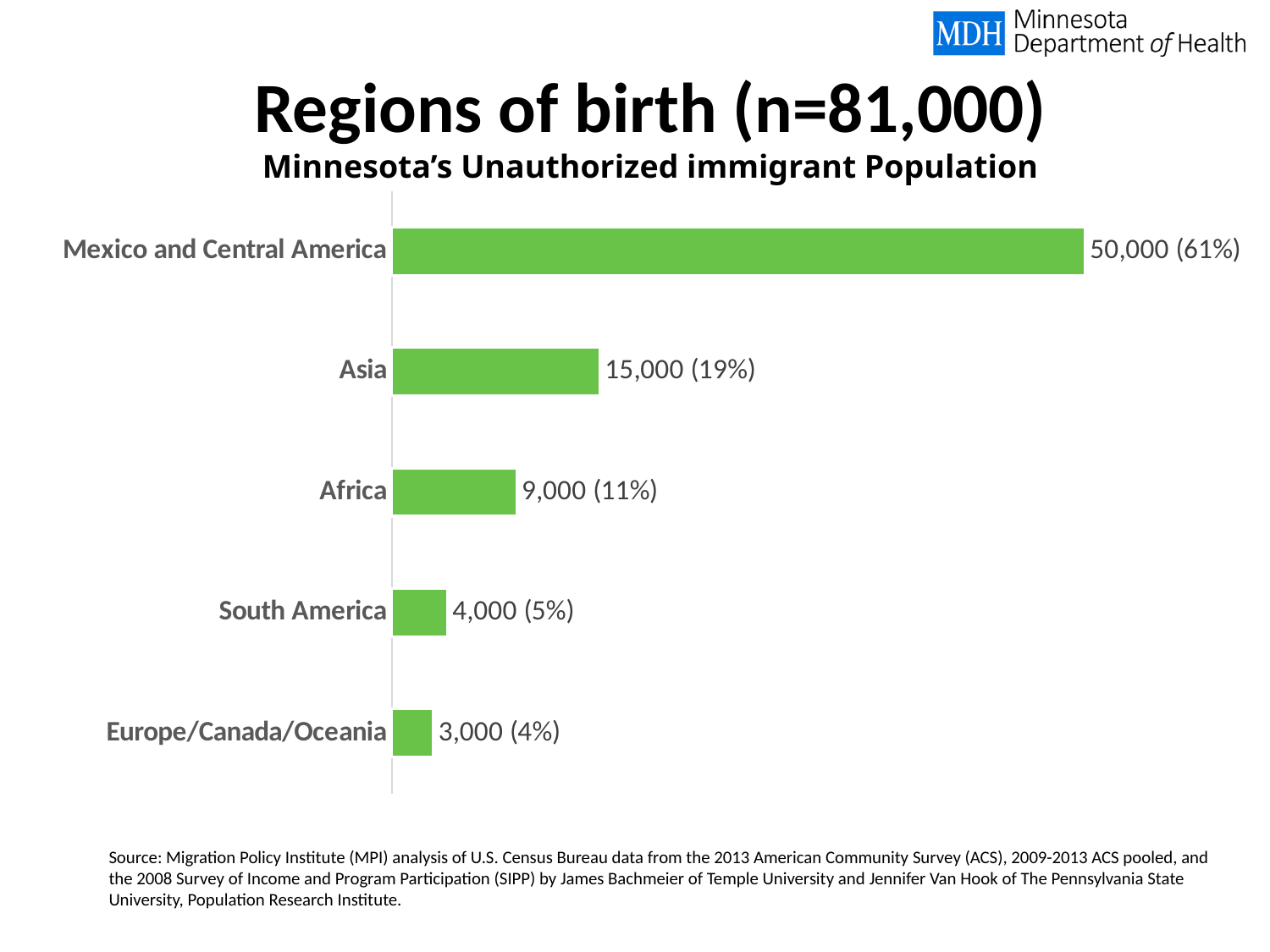
What is the value for Asia? 15,000 (19%) How many regions are shown in the chart? 5 What percentage is shown for South America? 5% What is the difference between the values for Mexico and Central America and Asia? 35,000 What is the title of the chart? Regions of birth (n=81,000) What is the value for Africa? 9,000 (11%) Which region has the lowest value? Europe/Canada/Oceania Which region has the highest value? Mexico and Central America What is the difference between the values for Africa and South America? 5,000 What is the value for Europe/Canada/Oceania? 3,000 (4%) What kind of chart is shown on the slide? Bar chart Which is larger, the value for Asia or the value for Africa? Asia